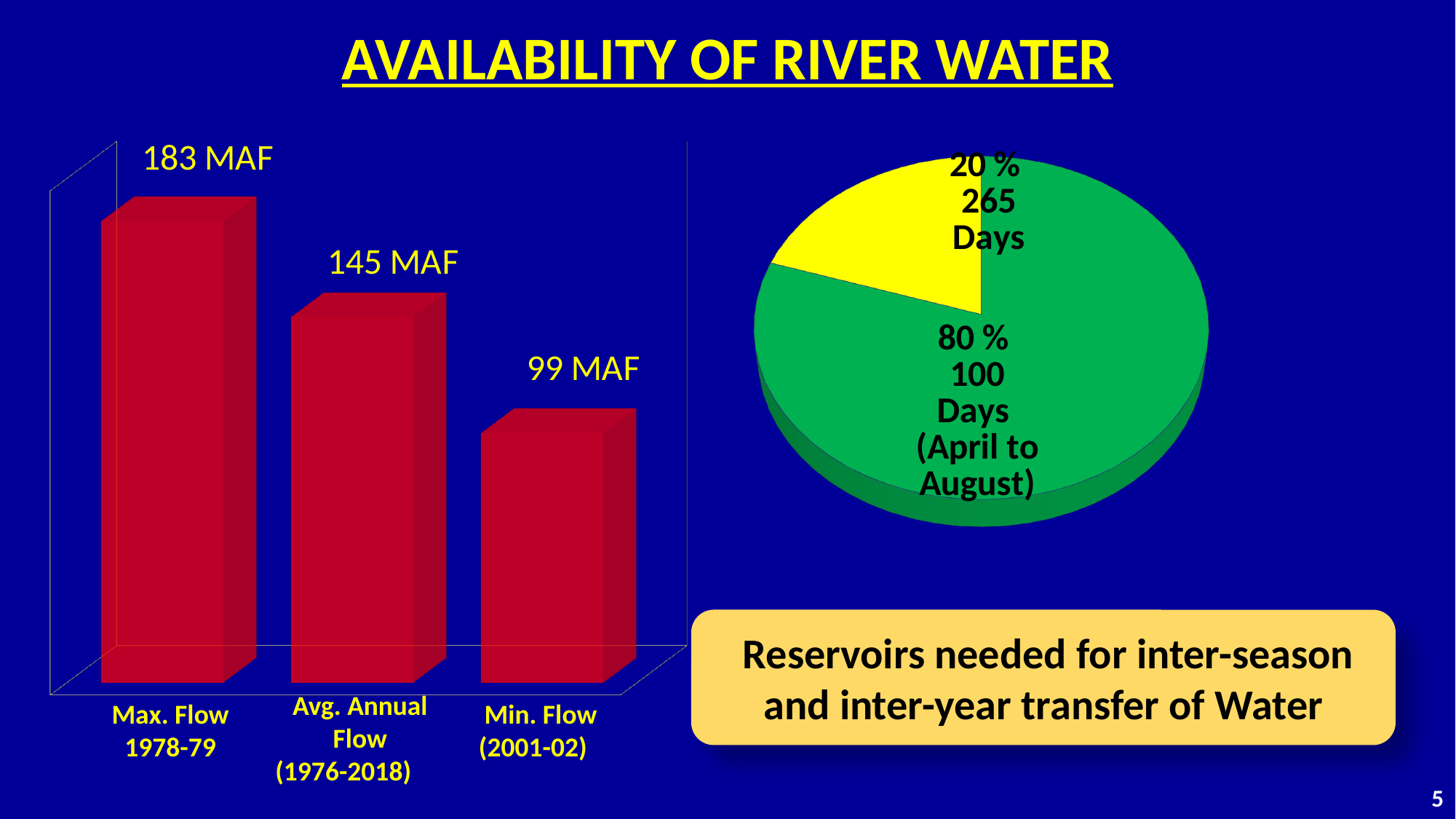
In the pie chart on the right, what share is labelled for the 265 Days slice? 20 % In the bar chart on the left, which category has the highest value? Max. Flow 1978-79 What kind of chart is shown on the left of the slide? bar chart In the bar chart on the left, what is the difference between Max. Flow 1978-79 and Min. Flow (2001-02)? 84 MAF In the bar chart on the left, what is the value for Max. Flow 1978-79? 183 MAF In the bar chart on the left, what is the value for Min. Flow (2001-02)? 99 MAF In the pie chart on the right, what share is labelled for the 100 Days (April to August) slice? 80 % In the bar chart on the left, how many categories are shown? 3 In the bar chart on the left, do the values rise or fall from left to right? fall In the pie chart on the right, what colour is the 265 Days slice? yellow In the bar chart on the left, which category has the lowest value? Min. Flow (2001-02) In the bar chart on the left, what is the value for Avg. Annual Flow (1976-2018)? 145 MAF